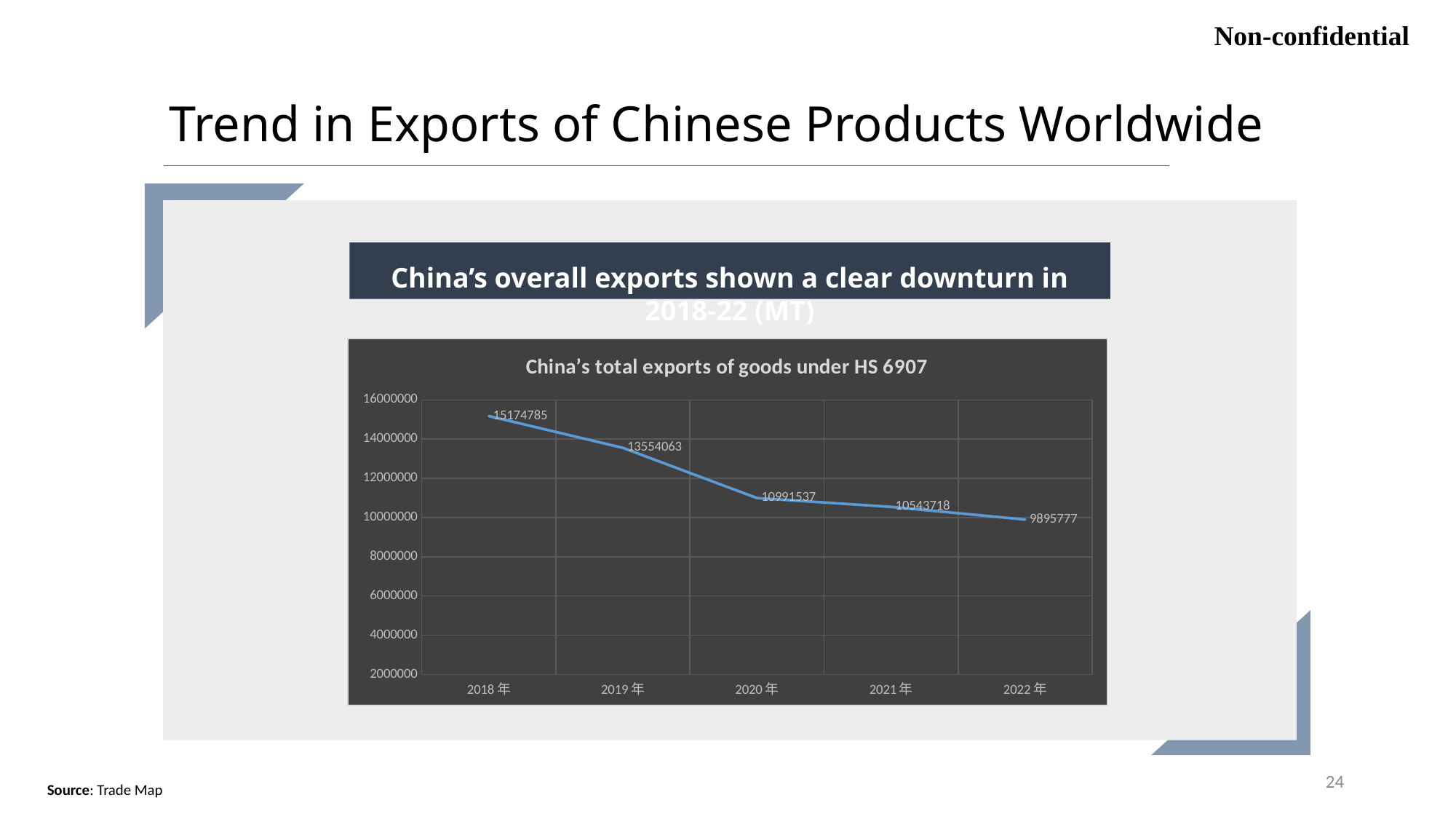
Which is larger, the value for 2019年 or the value for 2021年? 2019年 Do the values rise or fall from 2018年 to 2022年? Fall What is the title of the chart? China's total exports of goods under HS 6907 What is the difference between the values for 2018年 and 2022年? 5279008 What is the difference between the values for 2019年 and 2020年? 2562526 What is the value for 2022年? 9895777 Which year has the highest value? 2018年 What is the value for 2018年? 15174785 Which year has the lowest value? 2022年 What is the value for 2020年? 10991537 What type of chart is shown on the slide? Line chart How many years are plotted on the x axis? 5